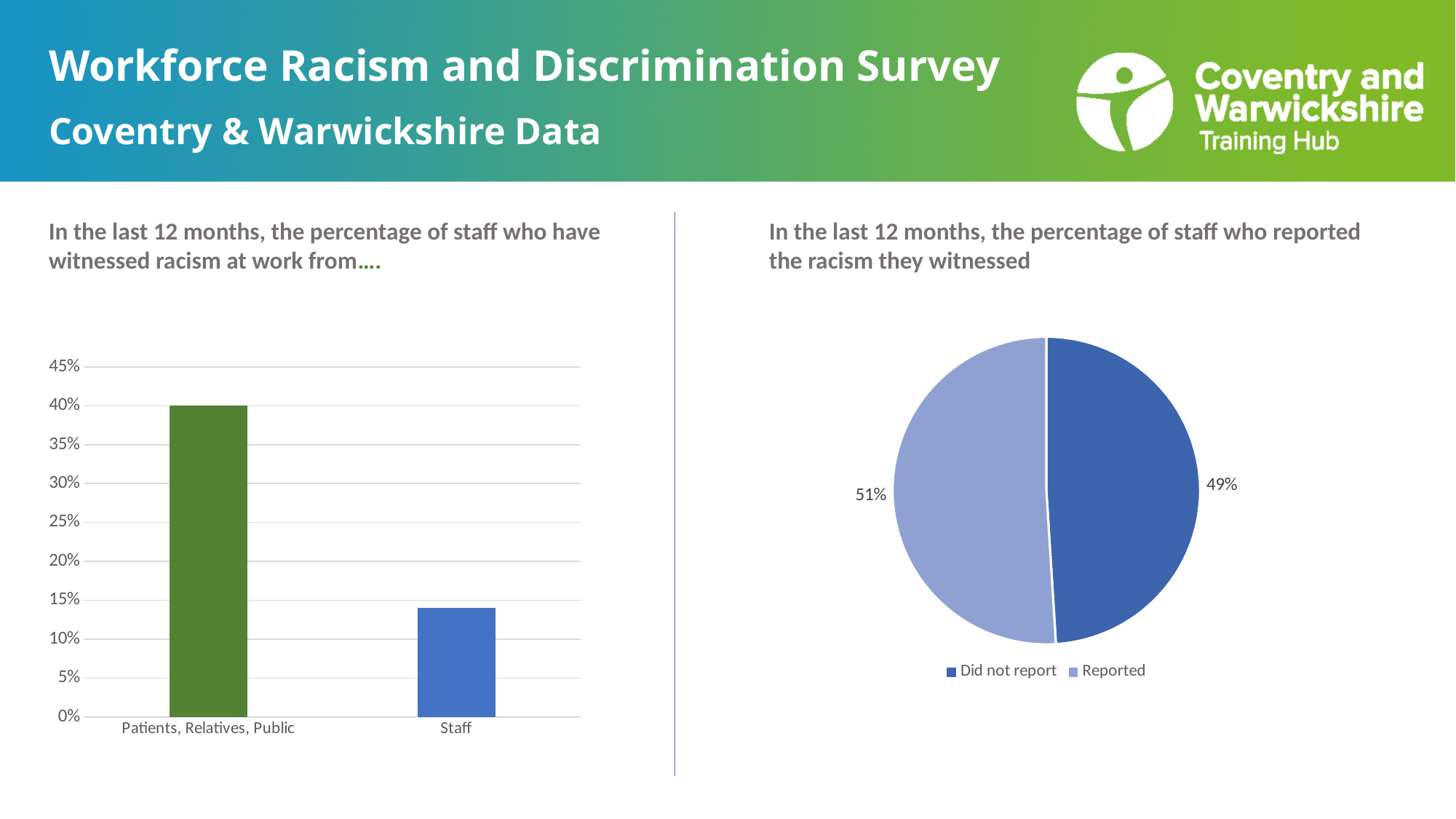
What kind of chart is on the right side of the slide? Pie chart In the left bar chart, is the value for Staff greater or less than 10%? greater In the left bar chart, which category has the lowest value? Staff In the pie chart on the right, what is the difference between the Reported and Did not report shares? 2% In the pie chart on the right, what percentage of staff reported the racism they witnessed? 51% How many entries does the legend of the pie chart on the right list? 2 In the pie chart on the right, what percentage of staff did not report the racism they witnessed? 49% In the pie chart on the right, which slice is larger, Did not report or Reported? Reported In the left bar chart, which category has the higher value? Patients, Relatives, Public In the left bar chart, what percentage of staff witnessed racism at work from Patients, Relatives, Public? 40% How many categories are shown in the left bar chart? 2 What kind of chart is on the left side of the slide? Bar chart